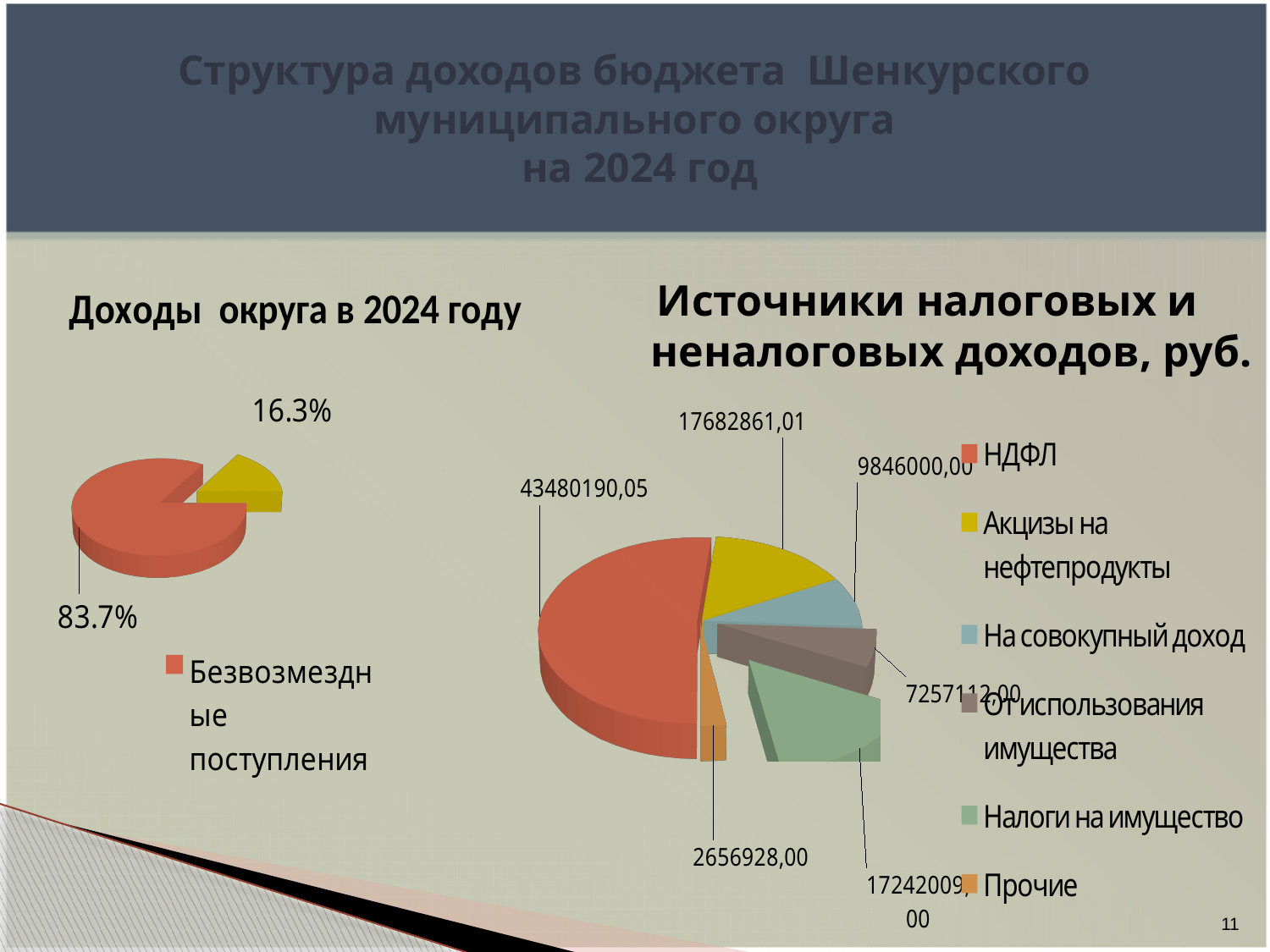
In the right chart "Источники налоговых и неналоговых доходов, руб.", what is the value for Налоги на имущество? 17242009,00 In the left chart "Доходы округа в 2024 году", what percentage is shown for the smaller yellow slice? 16.3% In the right chart "Источники налоговых и неналоговых доходов, руб.", what is the value for На совокупный доход? 9846000,00 In the right chart "Источники налоговых и неналоговых доходов, руб.", what is the value for Акцизы на нефтепродукты? 17682861,01 In the right chart "Источники налоговых и неналоговых доходов, руб.", what is the difference between the values for НДФЛ and Прочие? 40823262,05 In the right chart "Источники налоговых и неналоговых доходов, руб.", which source has the largest value? НДФЛ In the left chart "Доходы округа в 2024 году", what share is shown for Безвозмездные поступления? 83.7% How many entries does the legend of the right chart "Источники налоговых и неналоговых доходов, руб." list? 6 In the right chart "Источники налоговых и неналоговых доходов, руб.", which source has the smallest value? Прочие What kind of chart is the left chart titled "Доходы округа в 2024 году"? pie chart In the right chart "Источники налоговых и неналоговых доходов, руб.", what is the value for НДФЛ? 43480190,05 In the right chart "Источники налоговых и неналоговых доходов, руб.", what is the value for Прочие? 2656928,00